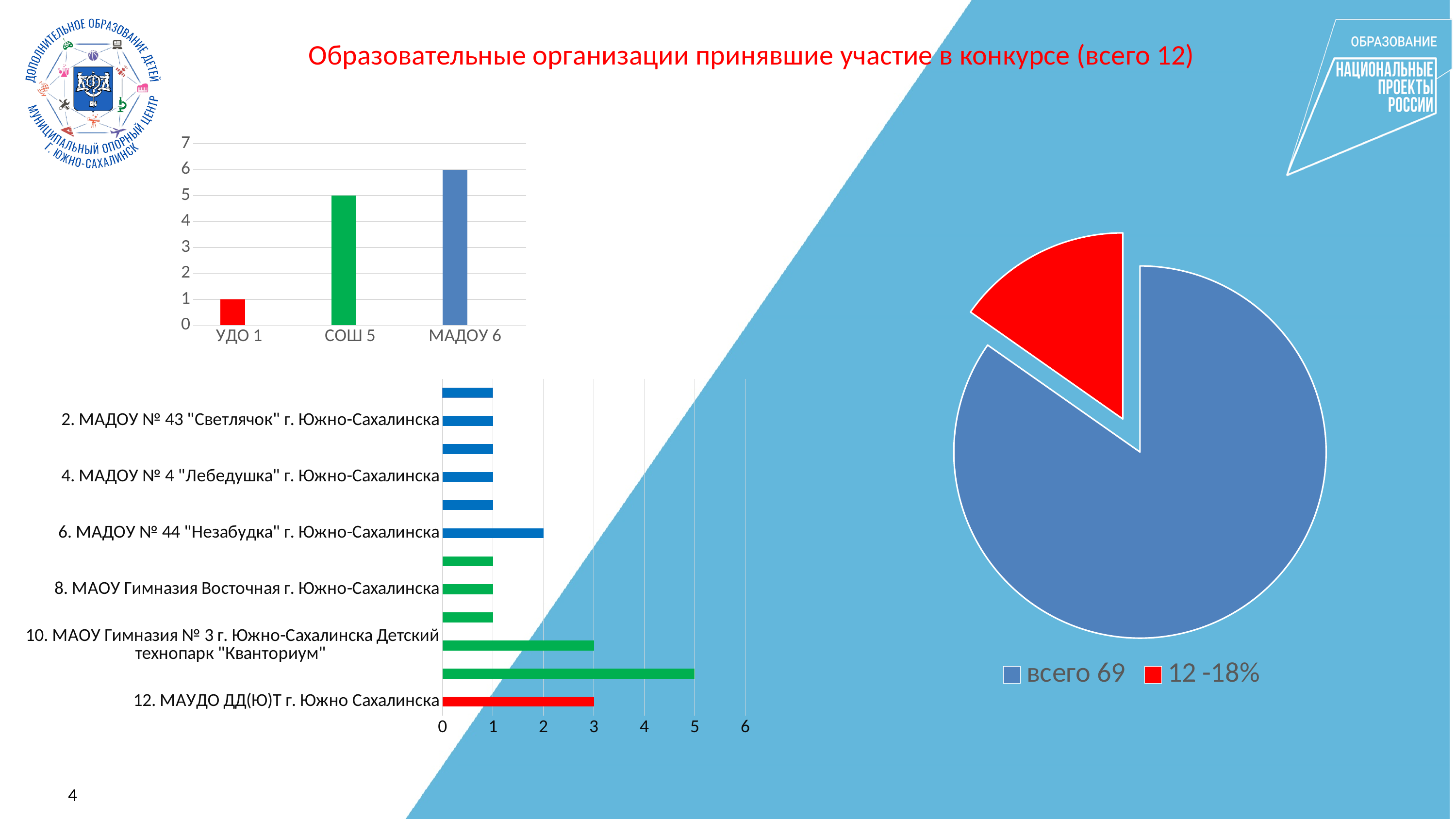
In the top-left bar chart, what is the value for СОШ 5? 5 In the horizontal bar chart at the bottom left, what is the value for 12. МАУДО ДД(Ю)Т г. Южно Сахалинска? 3 How many bars does the horizontal bar chart at the bottom left contain? 12 In the top-left bar chart, which category has the lowest value? УДО 1 In the horizontal bar chart at the bottom left, what is the value for 6. МАДОУ № 44 "Незабудка" г. Южно-Сахалинска? 2 How many categories does the top-left bar chart show? 3 What kind of chart is the top-left chart with categories УДО 1, СОШ 5 and МАДОУ 6? bar chart What kind of chart is shown on the right side of the slide? pie chart In the horizontal bar chart at the bottom left, which is larger: the value for 8. МАОУ Гимназия Восточная г. Южно-Сахалинска or the value for 10. МАОУ Гимназия № 3 г. Южно-Сахалинска Детский технопарк "Кванториум"? 10. МАОУ Гимназия № 3 г. Южно-Сахалинска Детский технопарк "Кванториум" How many entries does the legend of the pie chart on the right list? 2 In the top-left bar chart, what is the difference between the values for МАДОУ 6 and УДО 1? 5 In the top-left bar chart, which category has the highest value? МАДОУ 6